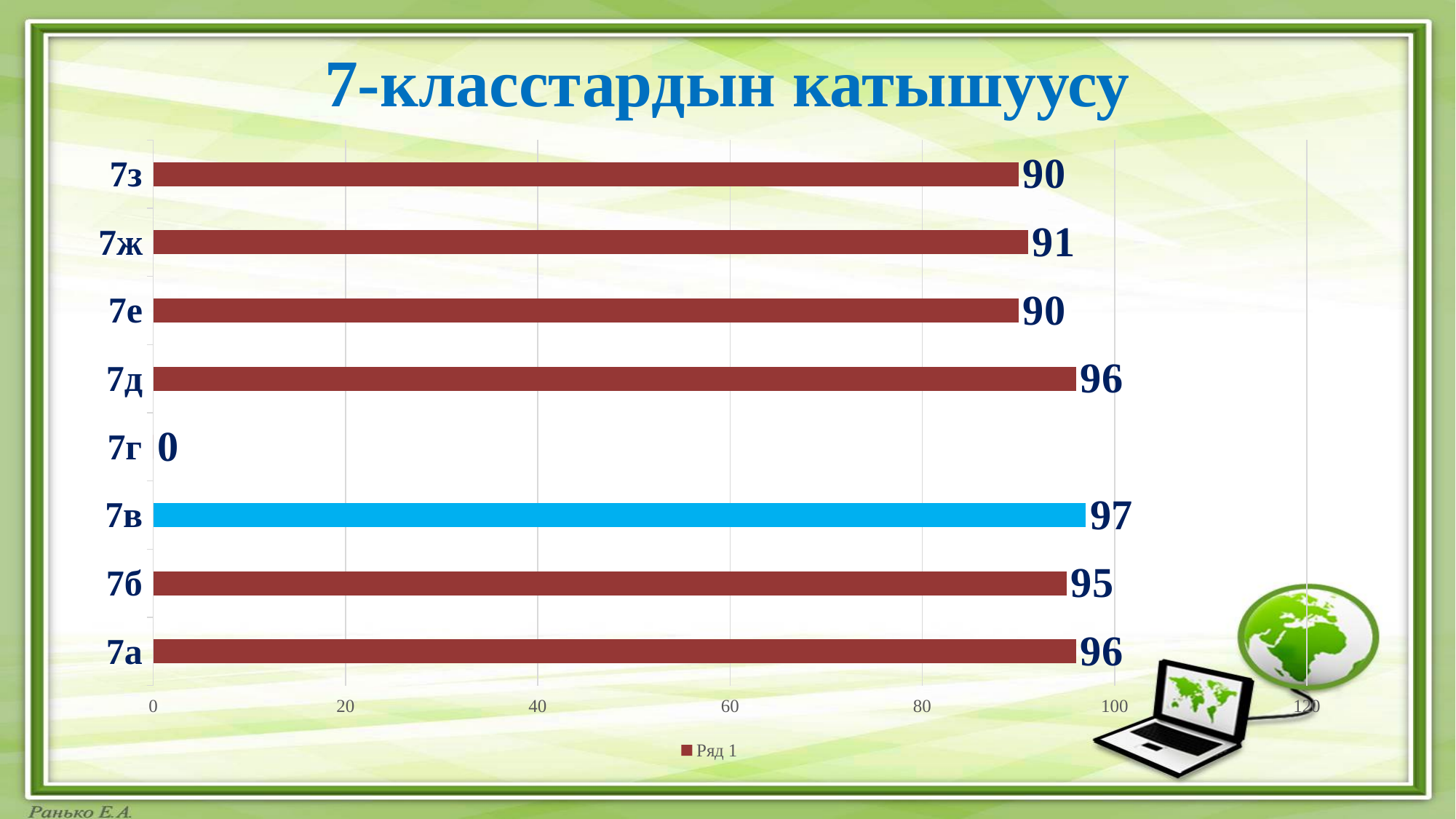
What is the value for 7г? 0 What is the title of the chart? 7-класстардын катышуусу How many categories are shown on the chart? 8 Is the value for 7а greater or less than 80? greater What is the difference between the values for 7в and 7з? 7 What is the value for 7в? 97 What is the value for 7ж? 91 What is the value for 7д? 96 What kind of chart is shown on the slide? bar chart Which is larger, the value for 7б or the value for 7е? 7б Which category has the lowest value? 7г Which category has the highest value? 7в